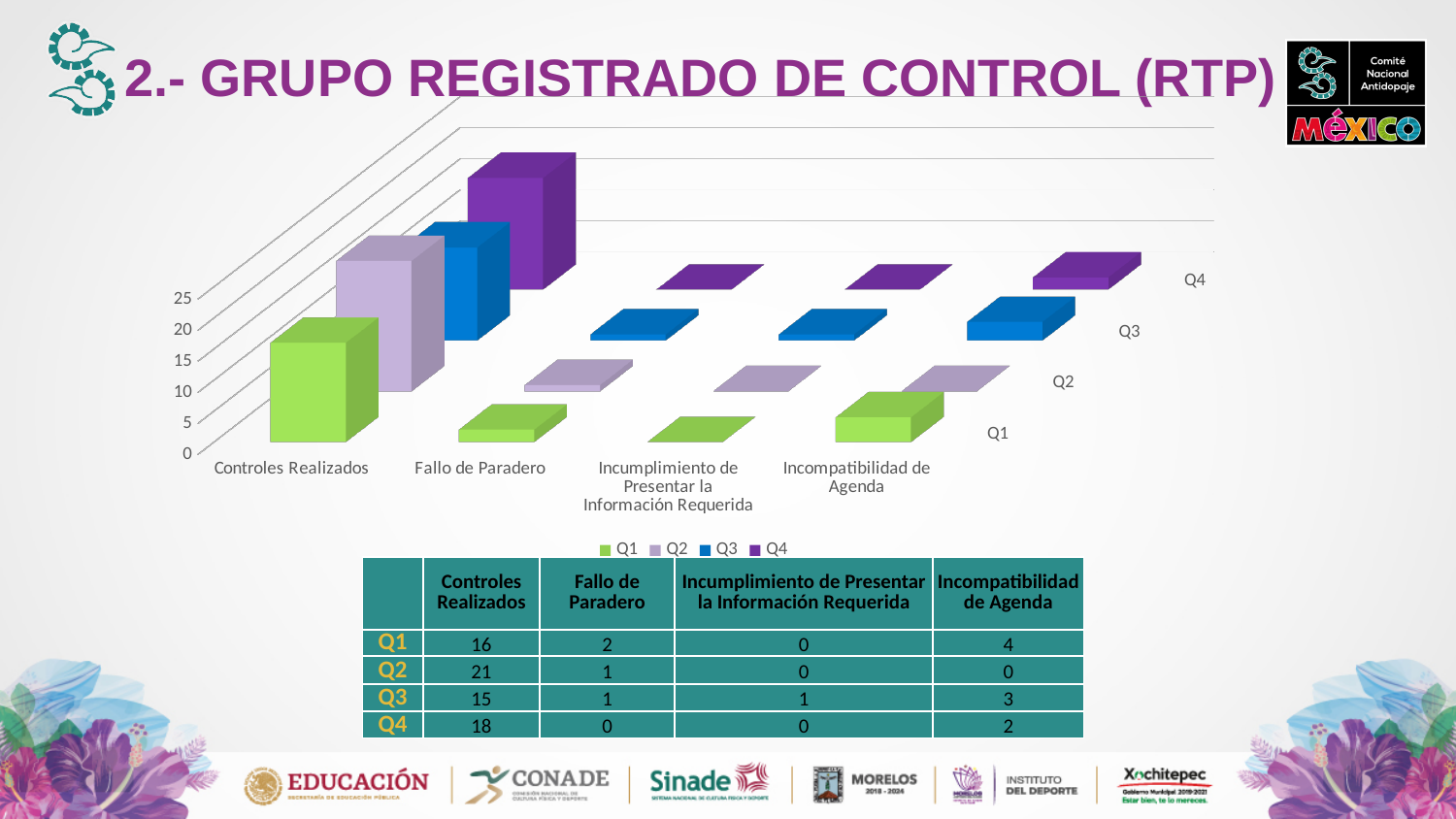
Which quarter has the highest value for Controles Realizados? Q2 What is the value for Controles Realizados in Q2? 21 How many series does the legend list? 4 Which quarter has the lowest value for Controles Realizados? Q3 Which is larger: the Q1 value for Incompatibilidad de Agenda or the Q1 value for Fallo de Paradero? Incompatibilidad de Agenda What is the value for Incumplimiento de Presentar la Información Requerida in Q3? 1 What is the difference between the Q2 and Q3 values for Controles Realizados? 6 What is the value for Incompatibilidad de Agenda in Q1? 4 How many categories are shown on the x axis of the chart? 4 What kind of chart is shown on the slide? bar chart What is the value for Fallo de Paradero in Q4? 0 Is the Q4 value for Controles Realizados greater or less than 15? greater